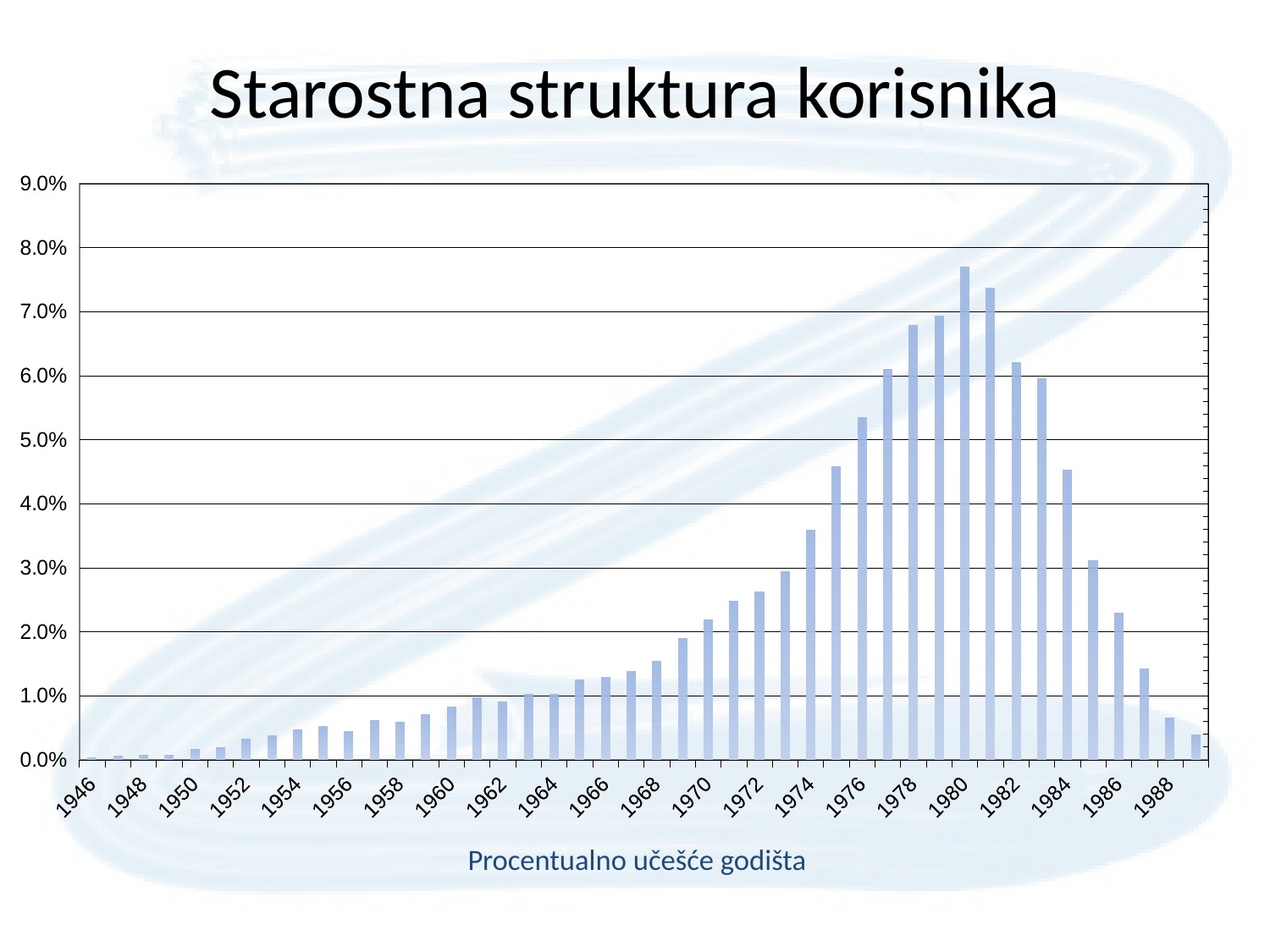
Is the value for 1980 greater or less than 7.0%? greater What kind of chart is shown on the slide? bar chart Is the value for 1978 greater or less than 6.0%? greater Is the value for 1976 greater or less than 5.0%? greater Which year has the highest value in the chart? 1980 What is the caption shown below the x axis of the chart? Procentualno učešće godišta What is the title of the chart on the slide? Starostna struktura korisnika Which is larger, the value for 1980 or the value for 1982? 1980 Do the values generally rise or fall from 1946 to 1980? rise